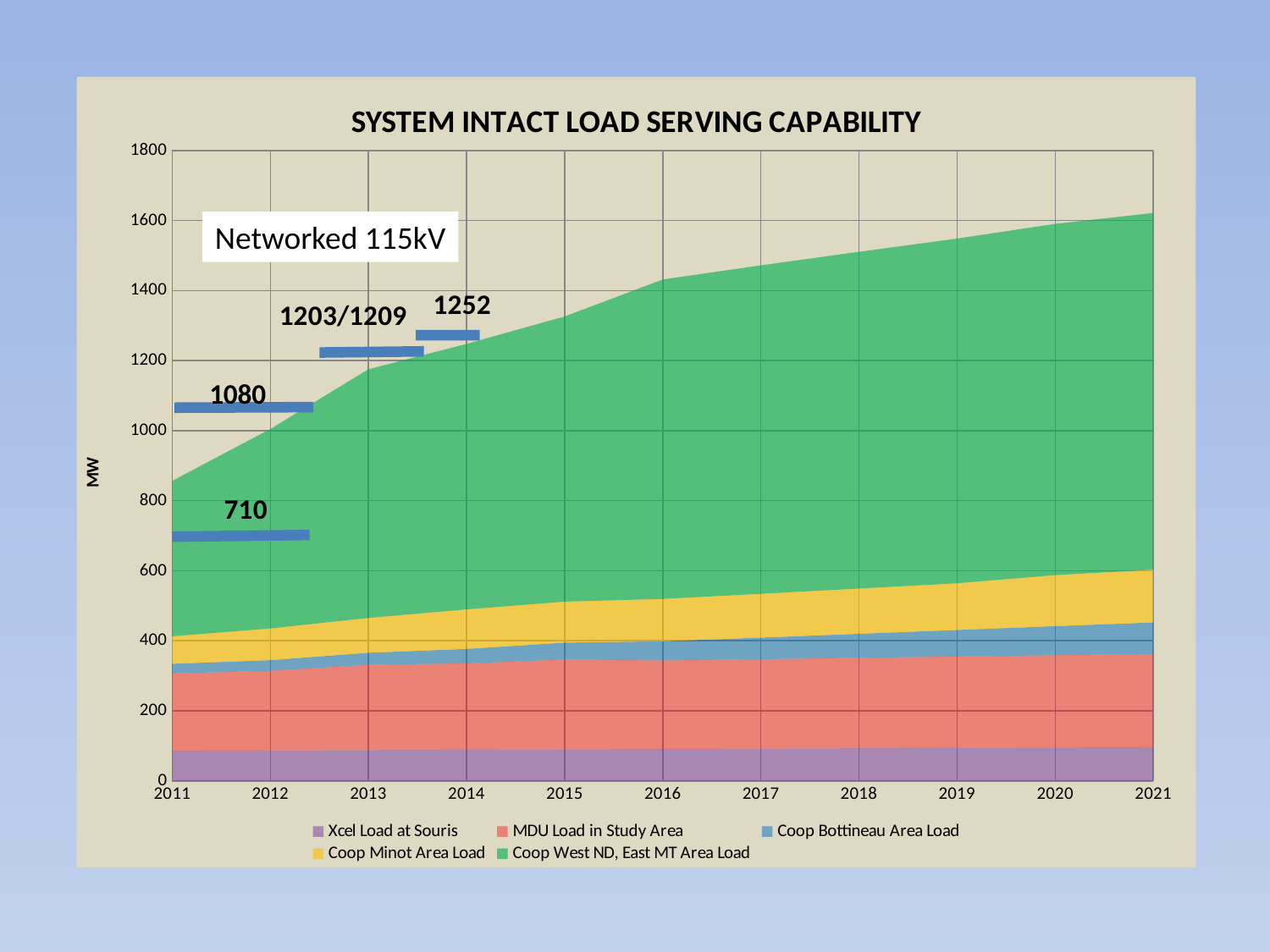
Which series occupies the largest area of the stack in 2021? Coop West ND, East MT Area Load Is the total stacked load in 2011 greater or less than 1000 MW? less Is the total stacked load in 2021 greater or less than 1400 MW? greater What type of chart is shown on the slide? Stacked area chart Is the Xcel Load at Souris in 2021 greater or less than 200 MW? less How many series does the legend list? 5 How many years are shown along the x axis? 11 What value is labeled on the lowest blue capability bar? 710 What is the title of the chart? SYSTEM INTACT LOAD SERVING CAPABILITY Does the total stacked load rise or fall from 2011 to 2021? Rises What unit is shown on the y axis label? MW What value is labeled on the highest blue capability bar? 1252